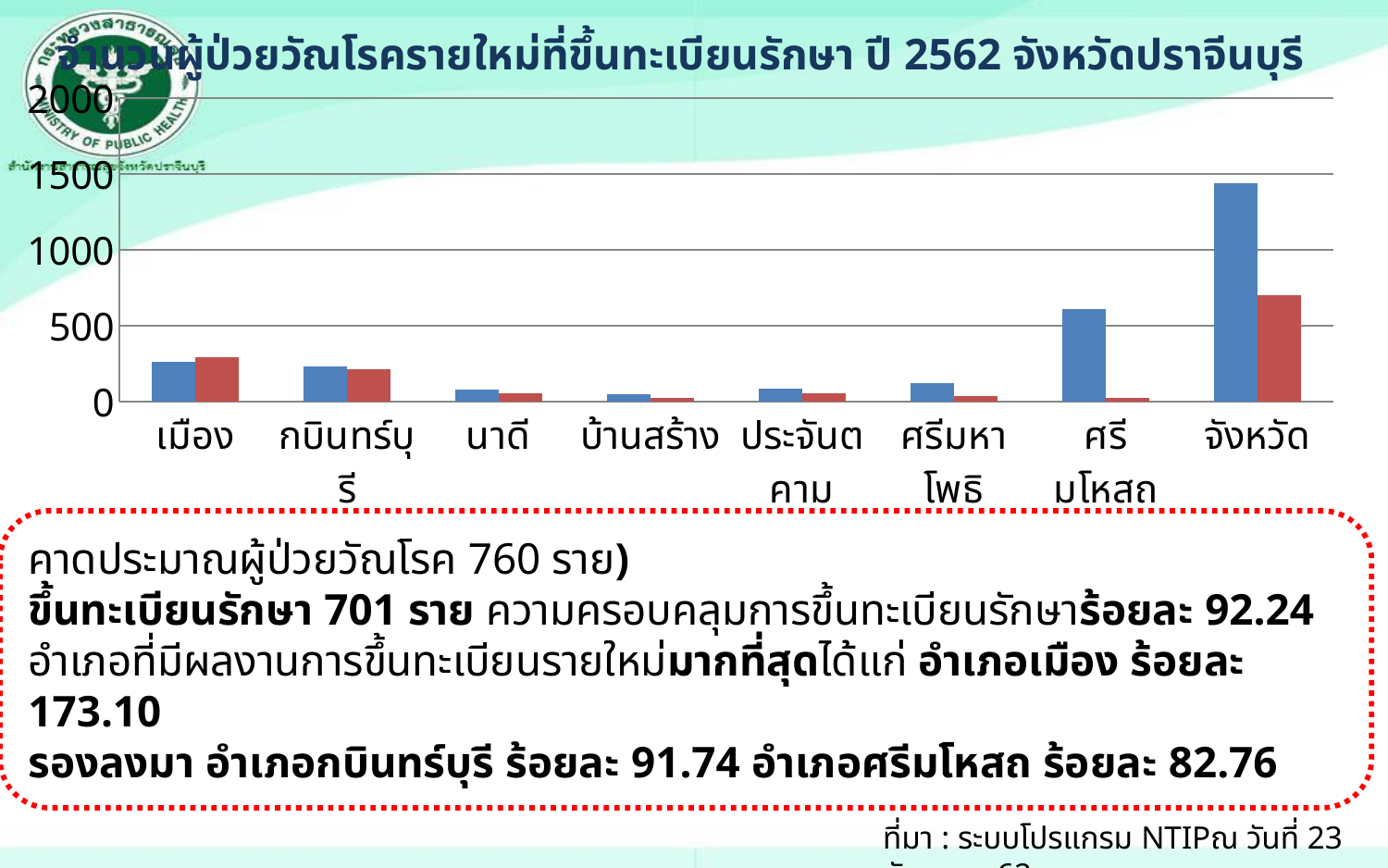
Is the blue bar for ศรีมโหสถ greater or less than 500? greater What kind of chart is shown on the slide? bar chart Is the blue bar for จังหวัด greater or less than 1000? greater What is the highest value shown on the y axis of the chart? 2000 Is the blue bar for เมือง greater or less than 500? less Which category has the tallest red bar? จังหวัด How many categories are shown on the x axis of the chart? 8 How many bars are shown for each category in the chart? 2 Which category has the tallest blue bar? จังหวัด Which has the larger blue bar, เมือง or นาดี? เมือง For ศรีมโหสถ, which bar is larger, the blue one or the red one? blue